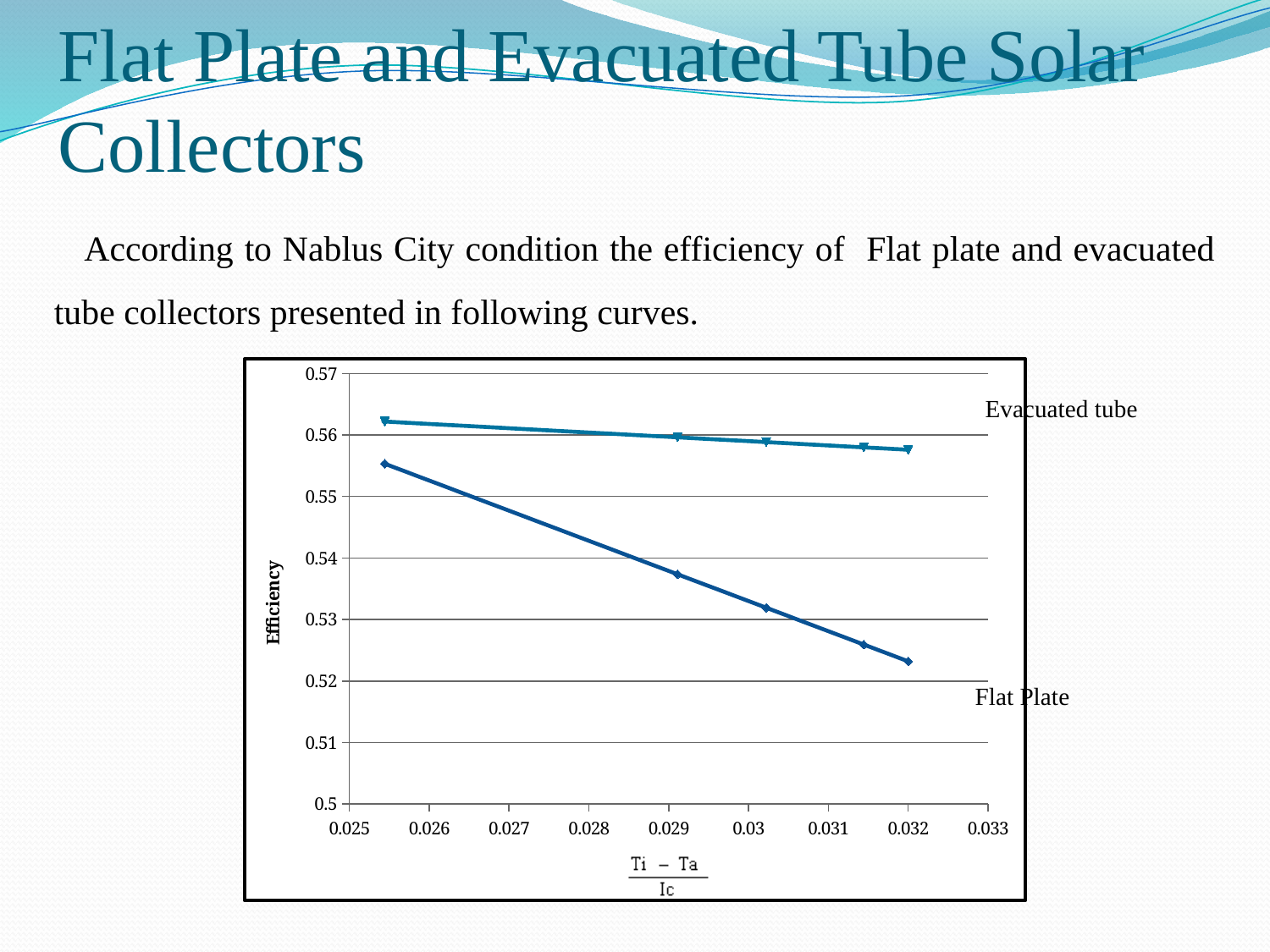
Which series shows the steeper decline in efficiency, Evacuated tube or Flat Plate? Flat Plate Do the Flat Plate efficiency values rise or fall as the x-axis value increases? fall Which series has the higher efficiency across the plotted range, Evacuated tube or Flat Plate? Evacuated tube How many series are plotted on the chart? 2 Is the efficiency of the Evacuated tube series at its leftmost point greater or less than 0.56? greater What are the names of the two series plotted on the chart? Evacuated tube and Flat Plate What kind of chart is shown on the slide? line chart What is the label of the vertical axis? Efficiency How many data points are plotted for the Flat Plate series? 5 Do the Evacuated tube efficiency values rise or fall as the x-axis value increases? fall Is the efficiency of the Flat Plate series at its leftmost point greater or less than 0.55? greater Is the efficiency of the Flat Plate series at its rightmost point (x = 0.032) greater or less than 0.53? less